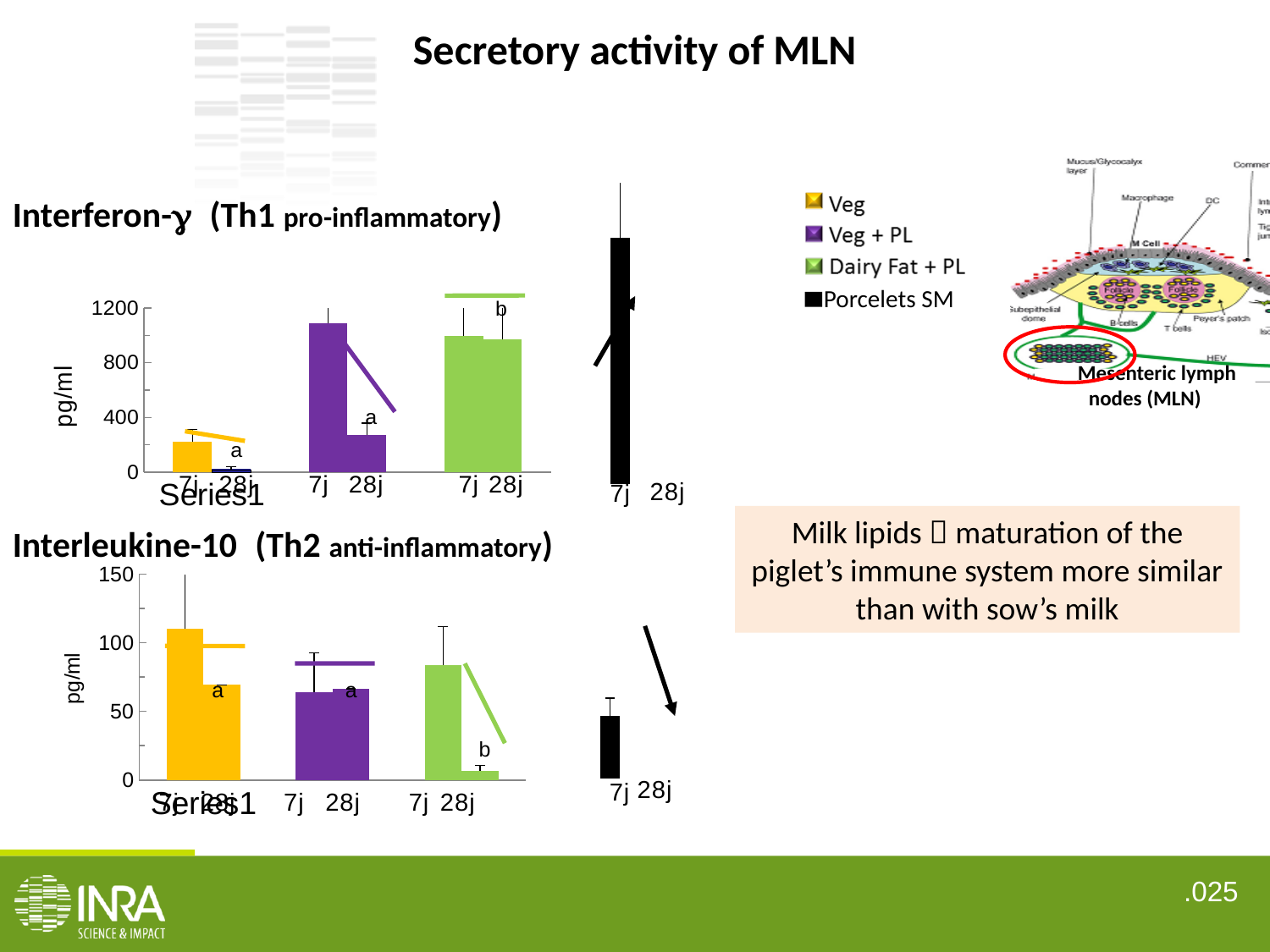
In the Interferon-γ chart, which group has the lowest value at 28j? Veg How many series does the legend list? 4 In the Interleukine-10 chart, is the value for Dairy Fat + PL at 28j greater or less than 50? less In the Interferon-γ chart, is the value for Veg + PL at 28j greater or less than 400? less In the Interferon-γ chart, does the value for Veg + PL rise or fall from 7j to 28j? fall In the Interferon-γ chart, is the value for Veg at 7j greater or less than 400? less In the Interferon-γ chart, which is larger for Veg + PL: the 7j value or the 28j value? 7j In the Interleukine-10 chart, which is larger for Dairy Fat + PL: the 7j value or the 28j value? 7j What kind of chart is the Interferon-γ chart? bar chart What unit is shown on the y axis of the Interleukine-10 chart? pg/ml